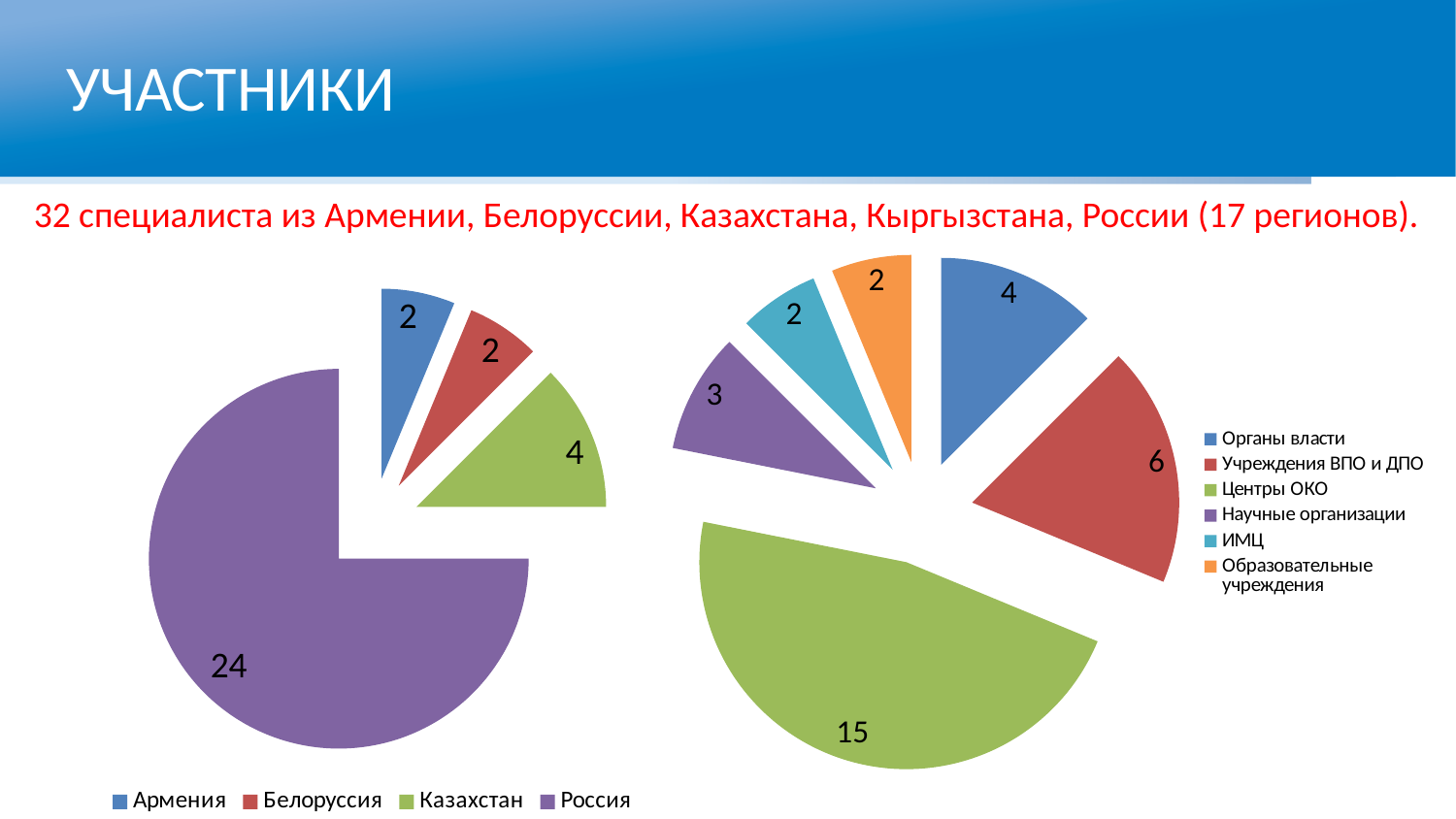
In the left pie chart, what is the value for Казахстан? 4 In the right pie chart, what is the value for Центры ОКО? 15 What type of chart is the left chart on the slide? pie chart In the left pie chart, what share of the total does Россия represent? 75% How many categories does the legend of the left pie chart list? 4 In the left pie chart, what is the value for Россия? 24 How many categories does the legend of the right pie chart list? 6 In the right pie chart, which is larger: Органы власти or Научные организации? Органы власти In the left pie chart, which category has the largest slice? Россия In the left pie chart, what is the difference between the values for Россия and Казахстан? 20 In the right pie chart, which category has the largest slice? Центры ОКО In the right pie chart, what is the value for Учреждения ВПО и ДПО? 6